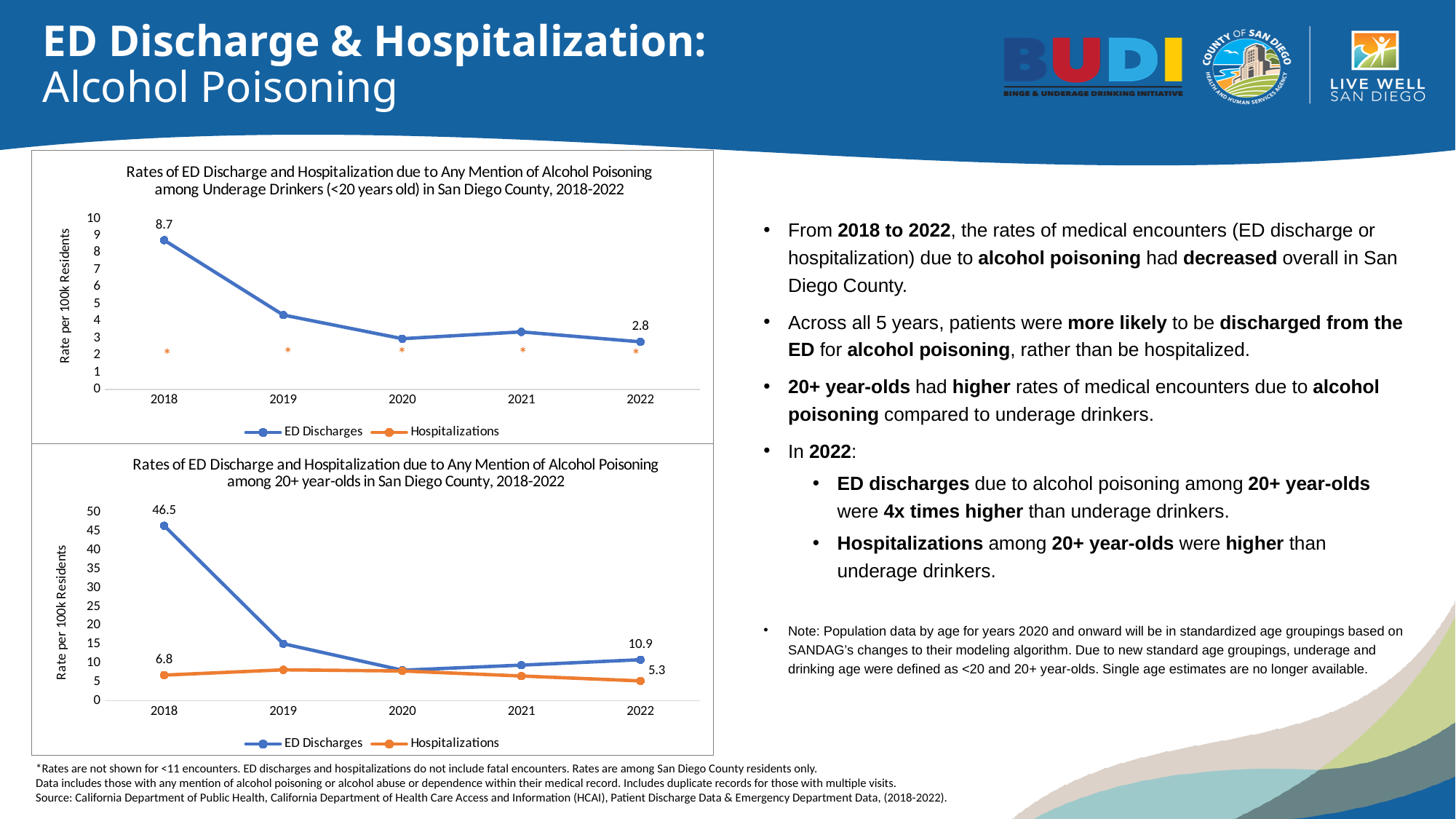
In the bottom chart (20+ year-olds), which year had the lowest ED Discharges rate? 2020 In the bottom chart (20+ year-olds), what was the rate of ED Discharges in 2018? 46.5 In the top chart (underage drinkers <20 years old), what was the rate of ED Discharges in 2018? 8.7 In the top chart (underage drinkers <20 years old), how does the ED Discharges rate change from 2018 to 2022? It decreases In the top chart (underage drinkers <20 years old), what was the rate of ED Discharges in 2022? 2.8 How many series does the legend of the bottom chart (20+ year-olds) list? 2 In the bottom chart (20+ year-olds), what is the difference between the ED Discharges rate in 2018 and in 2022? 35.6 In the bottom chart (20+ year-olds), what was the rate of Hospitalizations in 2022? 5.3 In the bottom chart (20+ year-olds), is the ED Discharges rate for 2019 greater or less than 20? less In the top chart (underage drinkers <20 years old), which year had the highest ED Discharges rate? 2018 What type of chart is the top chart (underage drinkers <20 years old)? Line chart In the bottom chart (20+ year-olds), what is the difference between the ED Discharges rate and the Hospitalizations rate in 2022? 5.6